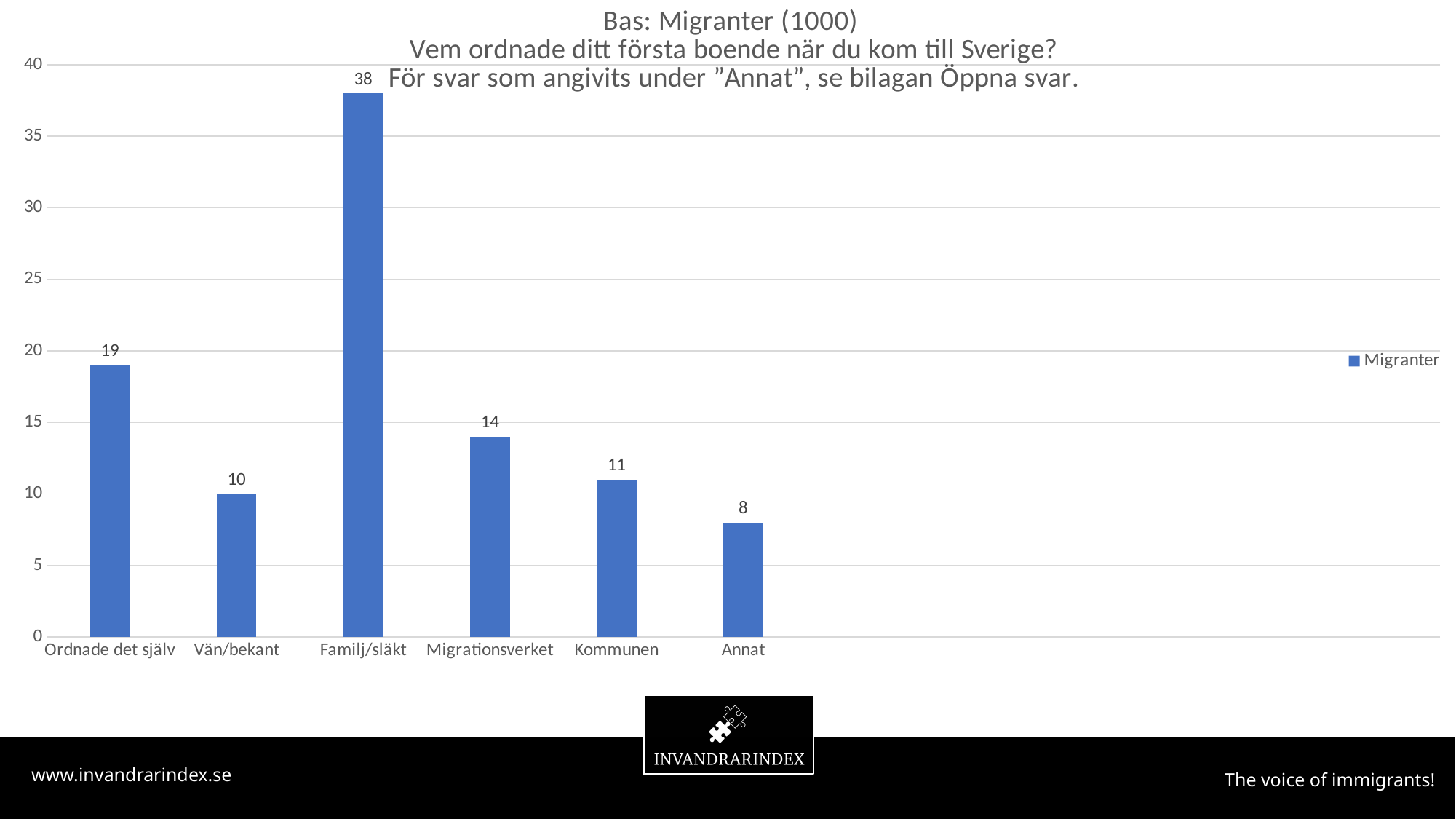
How many series does the legend list? 1 What is the name of the series shown in the legend? Migranter What is the value for Kommunen? 11 What is the value for Familj/släkt? 38 Which is larger, the value for Migrationsverket or the value for Vän/bekant? Migrationsverket Which category has the highest value? Familj/släkt Is the value for Kommunen greater or less than 10? greater What is the value for Ordnade det själv? 19 Which category has the lowest value? Annat How many categories are shown on the x axis? 6 What kind of chart is shown? bar chart What is the difference between the values for Familj/släkt and Ordnade det själv? 19